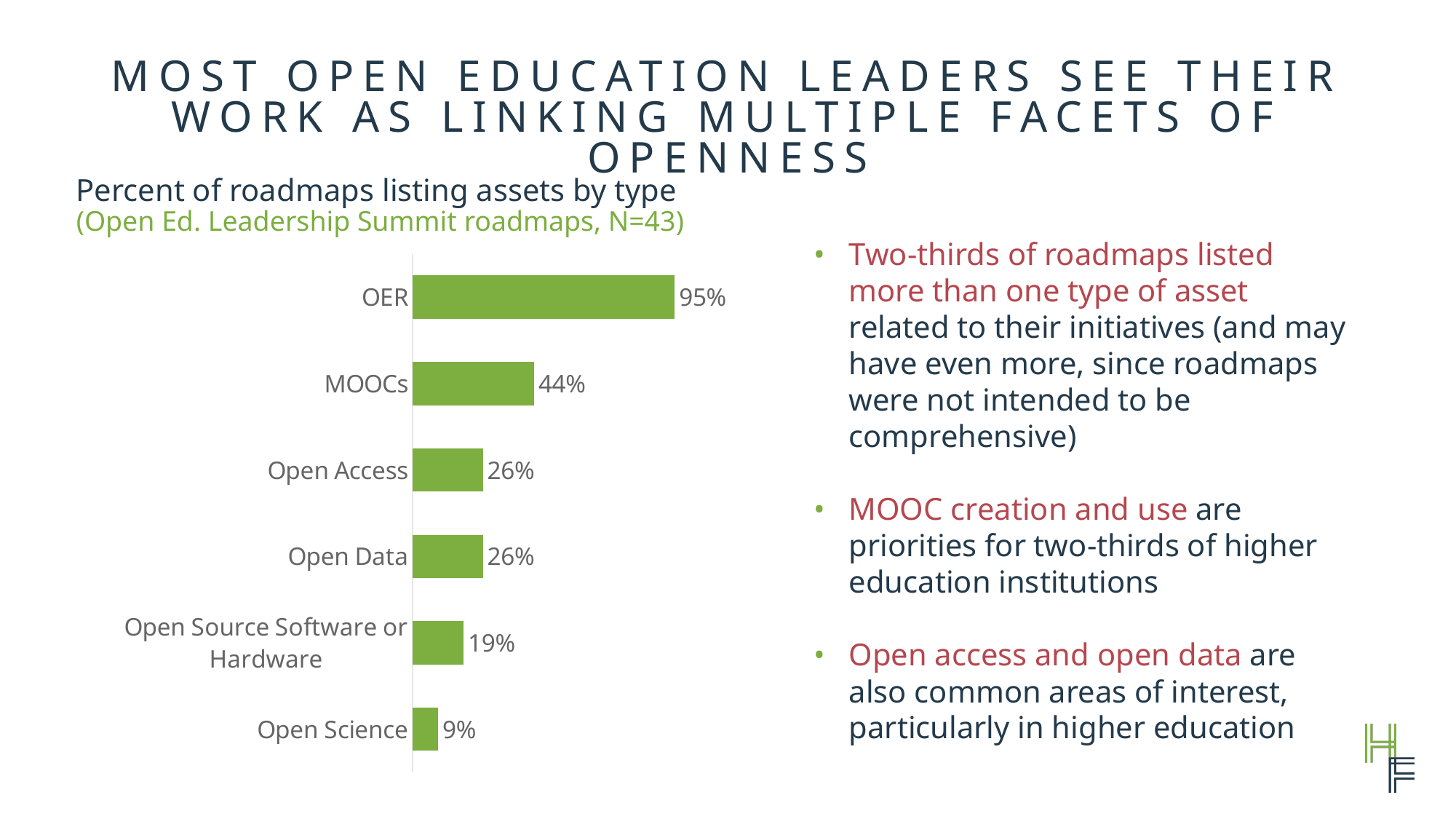
What is the value for Open Science? 9% Which is larger, the value for MOOCs or the value for Open Access? MOOCs What is the sample size (N) stated in the chart subtitle? N=43 What percent of roadmaps listed Open Source Software or Hardware? 19% Which asset type has the highest percentage of roadmaps? OER What kind of chart is shown on the slide? Bar chart What is the difference in percentage points between OER and MOOCs? 51 How many asset types are shown in the chart? 6 What percent of roadmaps listed OER as an asset? 95% What is the value shown for MOOCs? 44% Do Open Access and Open Data have the same value? Yes, both 26% Which asset type has the lowest percentage of roadmaps? Open Science